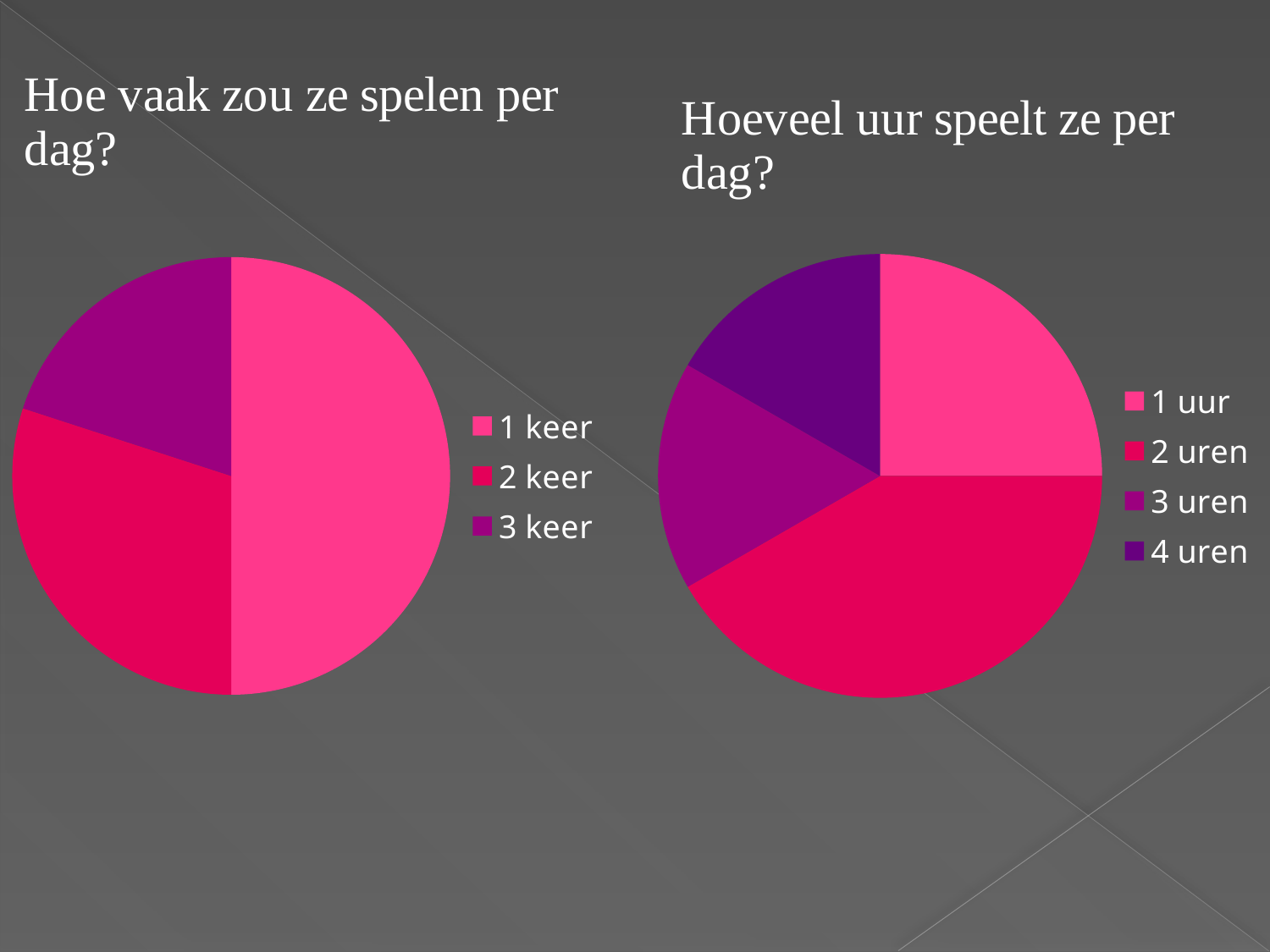
In the chart titled "Hoeveel uur speelt ze per dag?", how many slices does the pie have? 4 In the chart titled "Hoeveel uur speelt ze per dag?", which slice is larger: 2 uren or 1 uur? 2 uren In the chart titled "Hoe vaak zou ze spelen per dag?", how many slices does the pie have? 3 In the chart titled "Hoe vaak zou ze spelen per dag?", which slice is larger: 2 keer or 3 keer? 2 keer What is the title of the chart on the left of the slide? Hoe vaak zou ze spelen per dag? In the chart titled "Hoe vaak zou ze spelen per dag?", which category has the largest slice? 1 keer In the chart titled "Hoe vaak zou ze spelen per dag?", which category has the smallest slice? 3 keer What kind of chart is the chart titled "Hoe vaak zou ze spelen per dag?"? pie chart How many entries does the legend of the chart titled "Hoeveel uur speelt ze per dag?" list? 4 In the chart titled "Hoeveel uur speelt ze per dag?", which slice is larger: 1 uur or 3 uren? 1 uur What kind of chart is the chart titled "Hoeveel uur speelt ze per dag?"? pie chart In the chart titled "Hoeveel uur speelt ze per dag?", which category has the largest slice? 2 uren